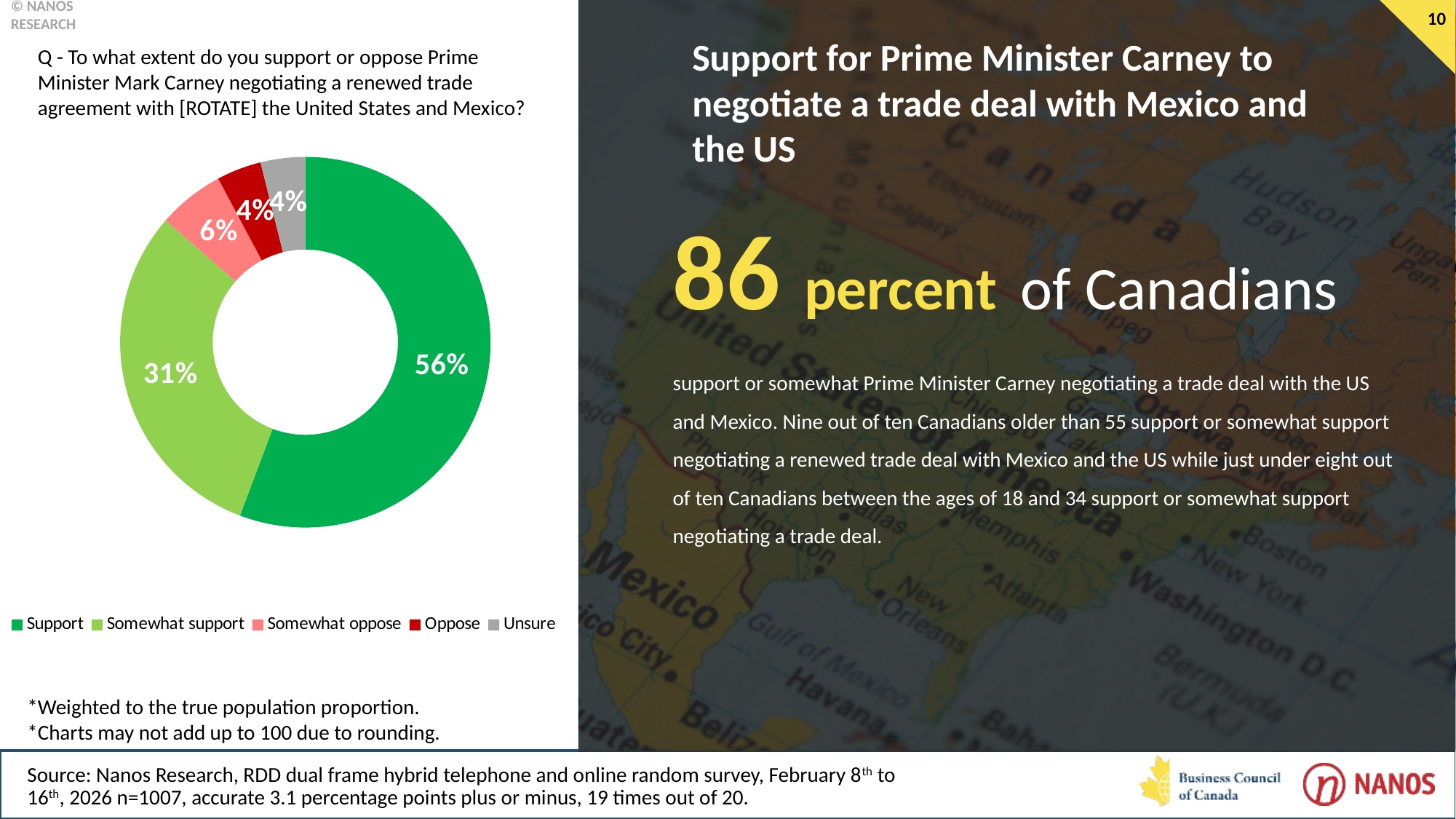
What colour represents the Unsure category in the chart? Grey What kind of chart is shown on the slide? Pie chart (doughnut) What is the combined share of Support and Somewhat support? 86% What percentage of respondents chose Somewhat oppose? 6% What is the combined share of Somewhat oppose and Oppose? 10% What is the difference in percentage points between Support and Somewhat support? 25 What percentage of respondents chose Support? 56% What percentage of respondents chose Oppose? 4% Which is larger, Somewhat support or Somewhat oppose? Somewhat support How many categories does the legend list? 5 Which category has the largest share of the pie? Support What percentage of respondents chose Somewhat support? 31%